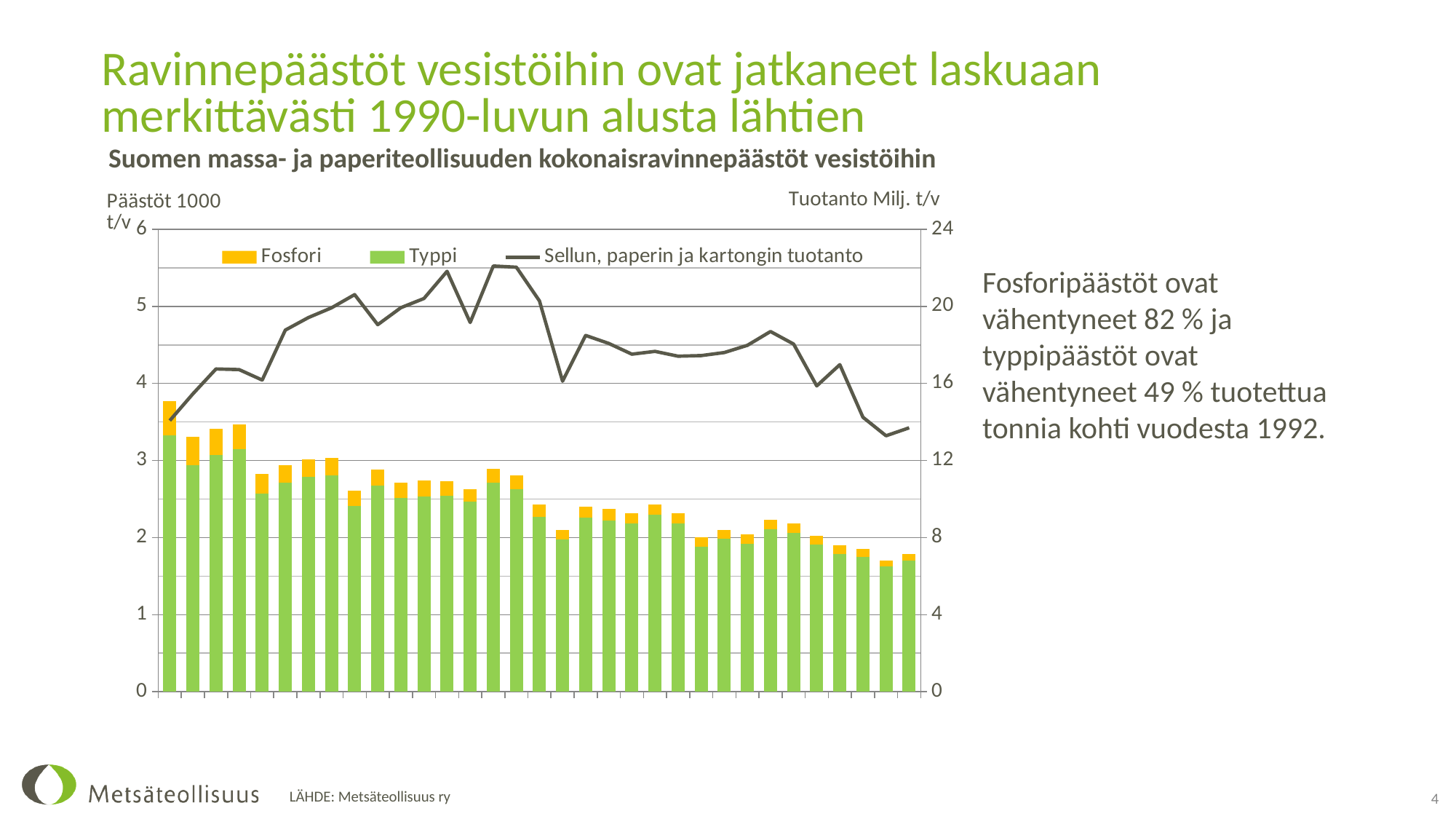
What kind of chart is shown on the slide? A stacked bar chart combined with a line chart Is the last point of the production line (Sellun, paperin ja kartongin tuotanto) greater or less than 16 on the right axis? less How many series does the chart's legend list? 3 What is the maximum value shown on the right-hand axis of the chart? 24 Which stacked bar is the tallest in the chart? The leftmost (first) bar Is the highest point of the production line (Sellun, paperin ja kartongin tuotanto) greater or less than 20 on the right axis? greater Do the stacked bars (Fosfori + Typpi) generally rise or fall from left to right along the x axis? Fall What colour are the Fosfori segments of the bars? Orange/yellow In each stacked bar, which segment is larger, Typpi or Fosfori? Typpi Is the total of the rightmost stacked bar greater or less than 2 on the left axis? less Which series in the chart is drawn as a line rather than bars? Sellun, paperin ja kartongin tuotanto